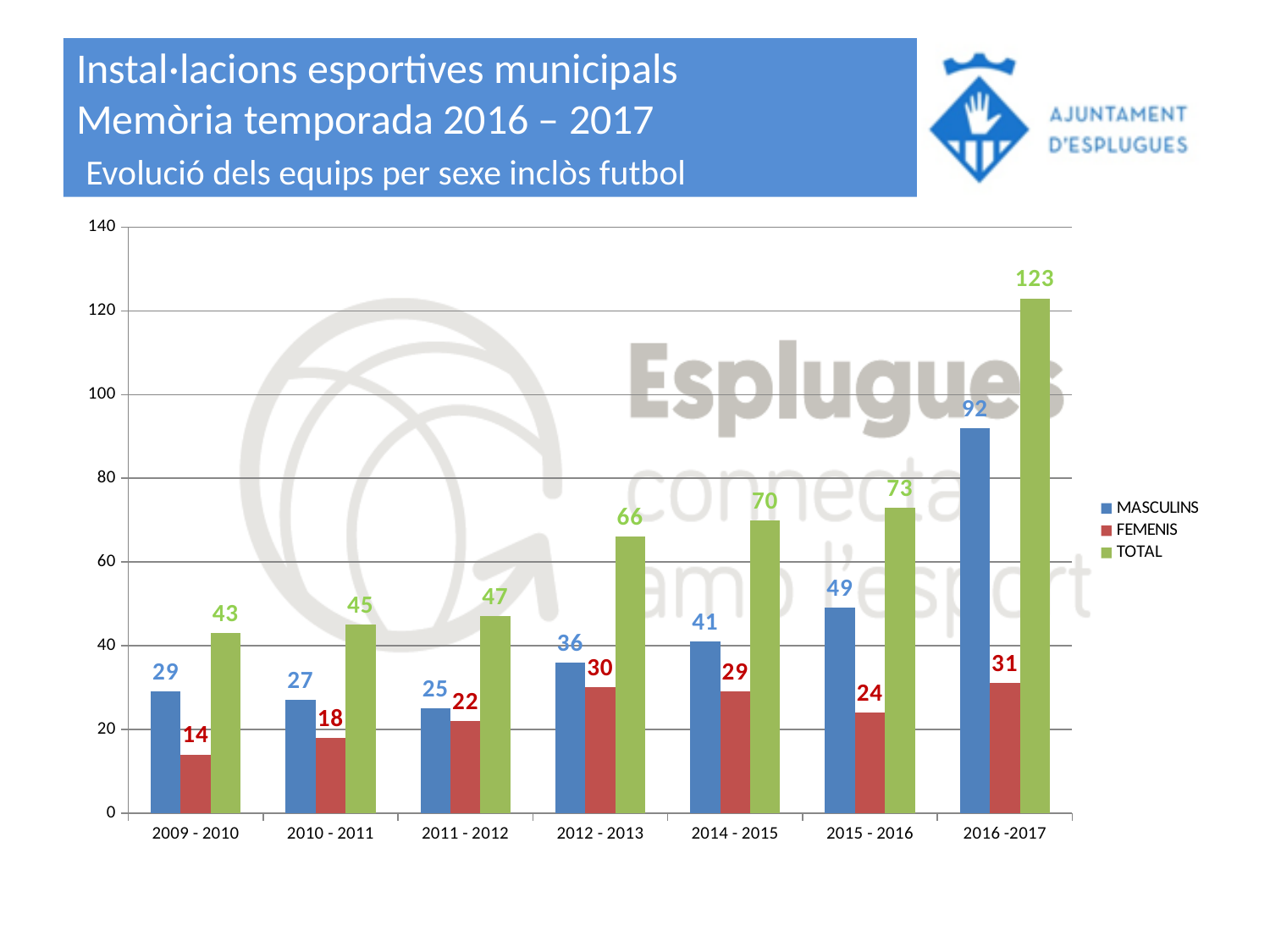
How many series does the legend list? 3 Which is larger in 2011 - 2012: the MASCULINS value or the FEMENIS value? MASCULINS How many seasons are shown on the x axis? 7 Which colour represents the TOTAL series in the legend? green What kind of chart is shown on the slide? bar chart What is the FEMENIS value for 2012 - 2013? 30 What is the TOTAL value for 2014 - 2015? 70 Which season has the lowest FEMENIS value? 2009 - 2010 What is the difference between the MASCULINS and FEMENIS values in 2015 - 2016? 25 Which season has the highest TOTAL value? 2016 -2017 What is the MASCULINS value for 2016 -2017? 92 Does the TOTAL series rise or fall from 2009 - 2010 to 2016 -2017? rise